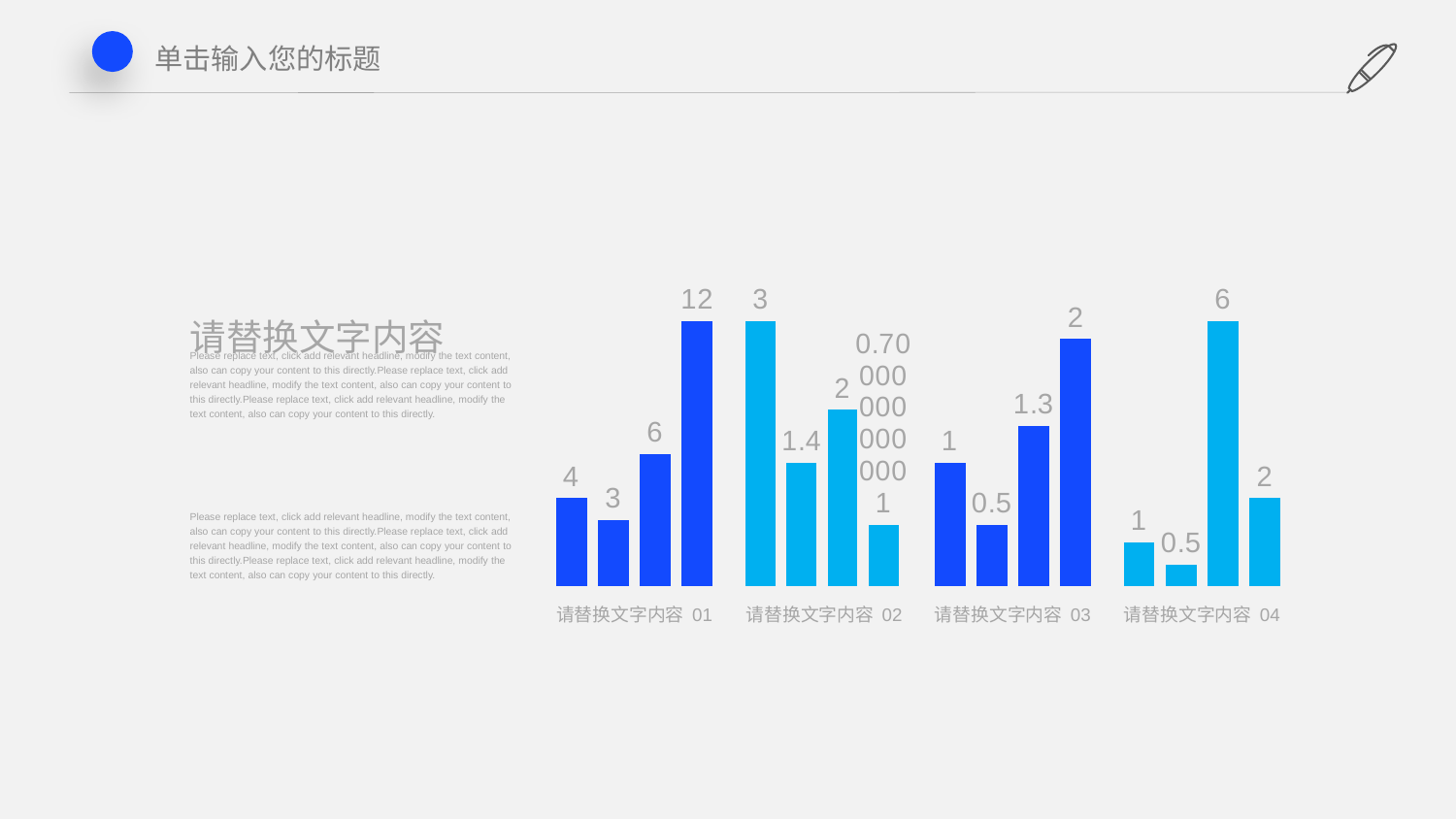
Which is larger: the tallest bar in 请替换文字内容 01 or the tallest bar in 请替换文字内容 04? 请替换文字内容 01 What is the value of the third bar in the category 请替换文字内容 03? 1.3 What is the value of the second bar in the category 请替换文字内容 02? 1.4 What is the value of the tallest bar in the category 请替换文字内容 04? 6 What type of chart is shown on the slide? bar chart What is the sum of the four bar values in the category 请替换文字内容 01? 25 What is the difference between the tallest bar (12) and the first bar (4) in the category 请替换文字内容 01? 8 What colour are the bars in the category 请替换文字内容 02? light blue What is the value of the first bar in the category 请替换文字内容 01? 4 How many categories are shown along the x axis of the chart? 4 What is the value of the tallest bar in the category 请替换文字内容 01? 12 Which category contains the highest bar in the chart? 请替换文字内容 01